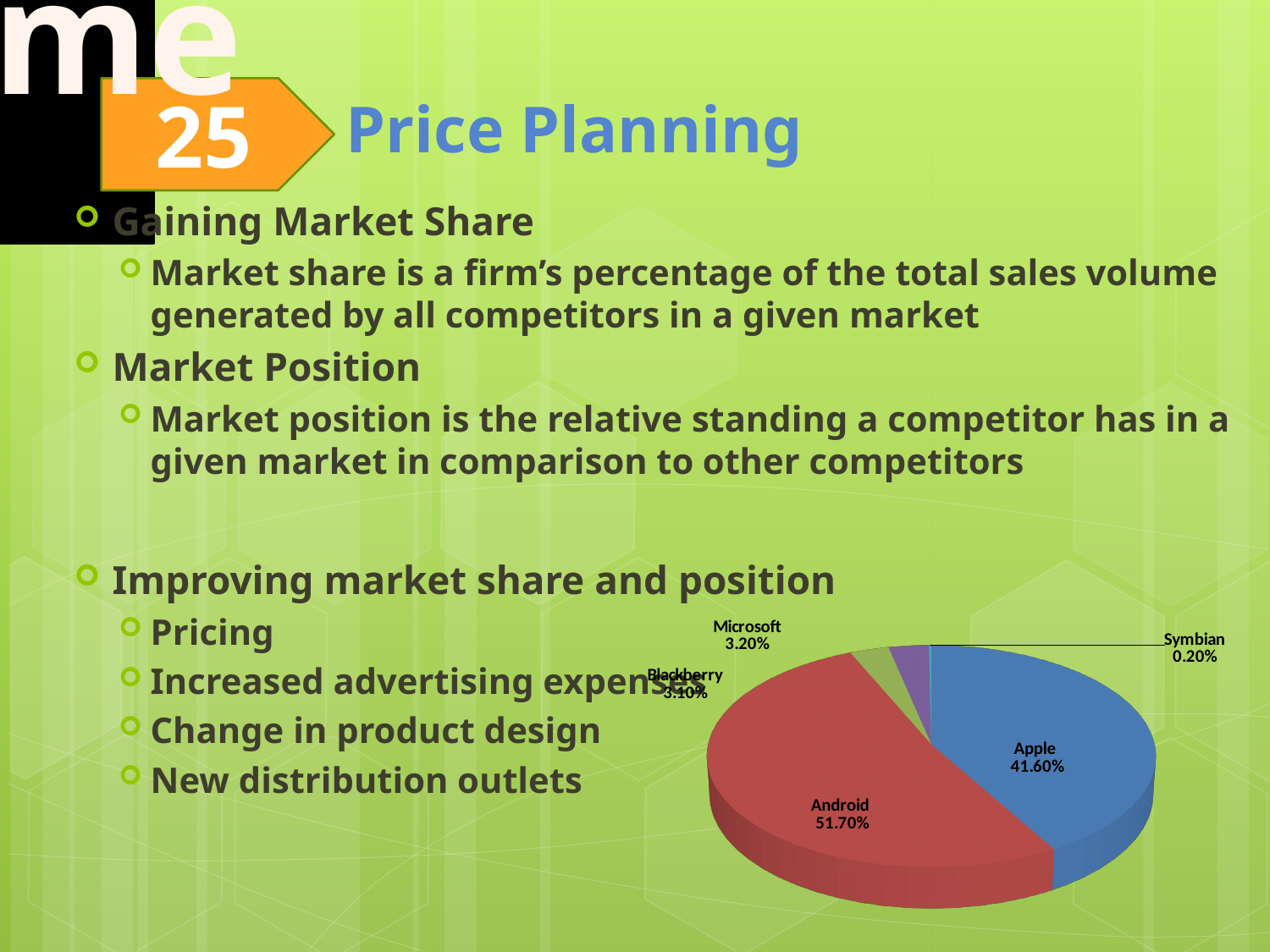
How many slices does the pie chart have? 5 Which slice of the pie chart is the largest? Android What kind of chart is shown on the slide? pie chart What is the value for Microsoft in the pie chart? 3.20% What is the value for Apple in the pie chart? 41.60% What is the value for Blackberry in the pie chart? 3.10% Which is larger in the pie chart, Apple or Android? Android What is the difference between the Android and Apple values in the pie chart? 10.10% What colour is the Android slice in the pie chart? red What is the value for Android in the pie chart? 51.70% What is the value for Symbian in the pie chart? 0.20% Which slice of the pie chart is the smallest? Symbian